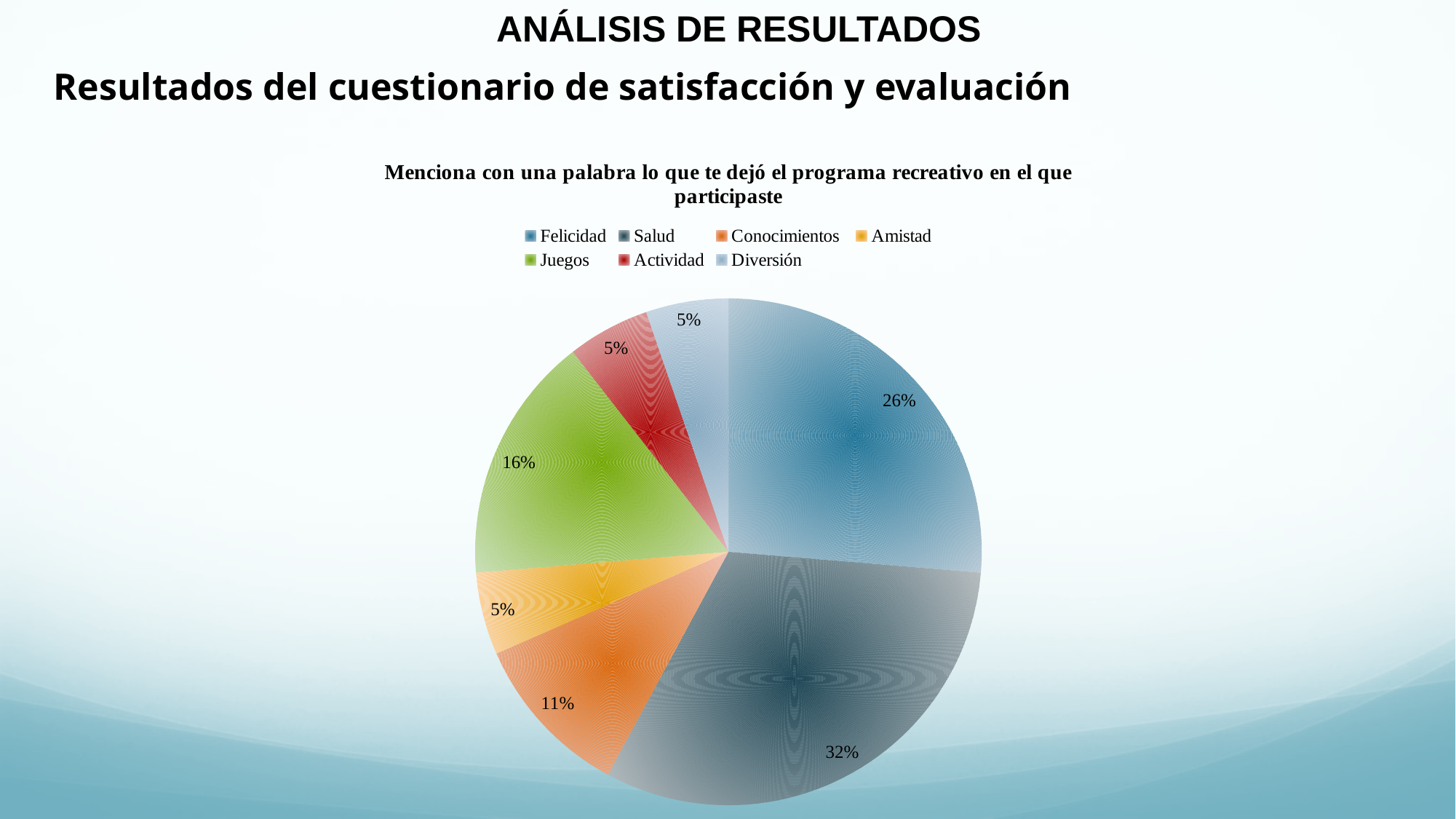
What colour is the slice for Juegos? green What is the difference in percentage points between Salud and Felicidad? 6 How many categories does the legend list? 7 What percentage of the pie does Conocimientos represent? 11% What percentage of the pie does Juegos represent? 16% What percentage of the pie does Amistad represent? 5% Which category has the largest share of the pie? Salud What percentage of the pie does Felicidad represent? 26% What kind of chart is shown on the slide? pie chart Which is larger, the share for Juegos or the share for Conocimientos? Juegos What is the title of the chart? Menciona con una palabra lo que te dejó el programa recreativo en el que participaste What percentage of the pie does Salud represent? 32%